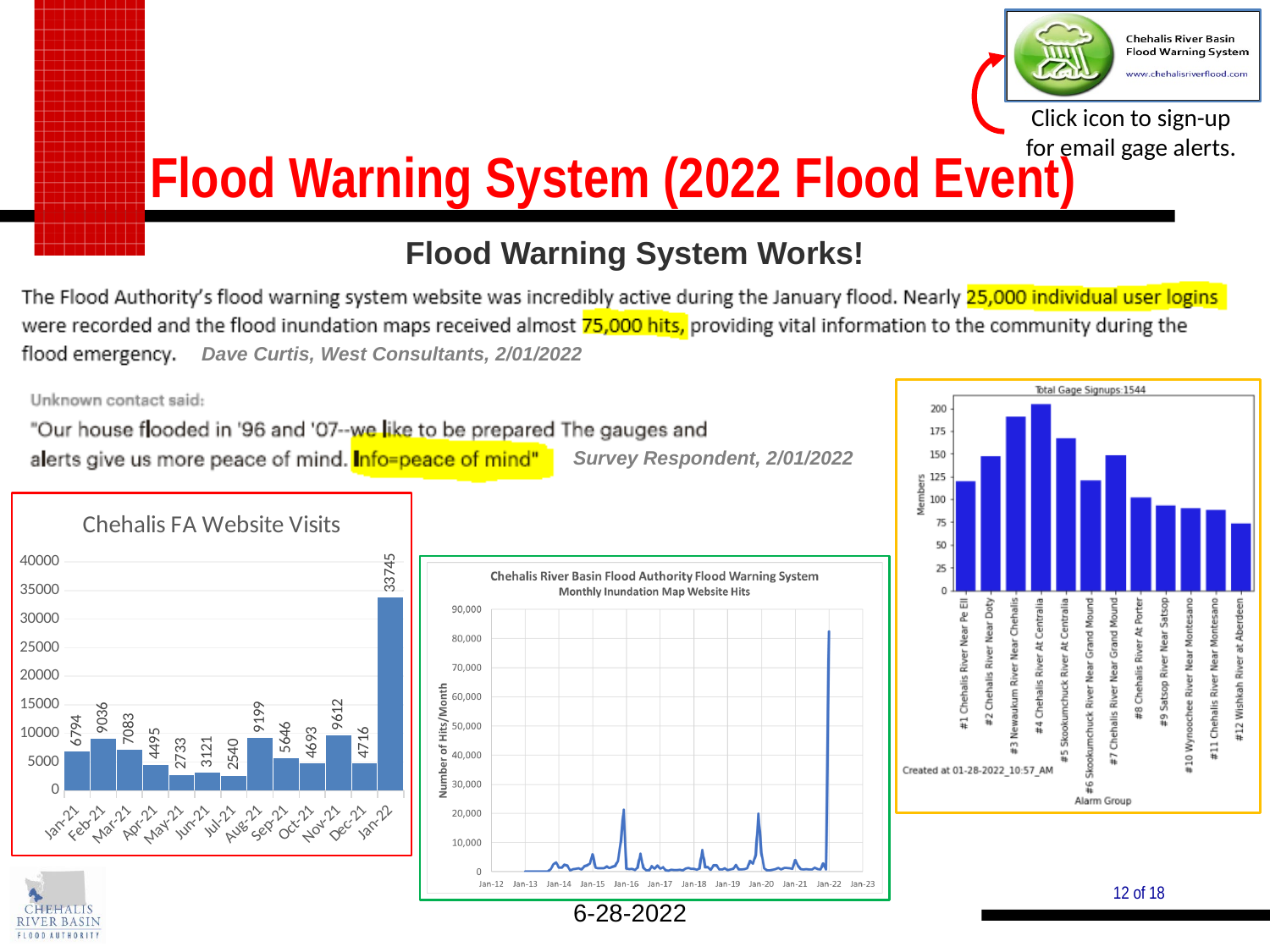
In the Total Gage Signups chart, is the value for #12 Wishkah River at Aberdeen greater or less than 100? less In the Chehalis FA Website Visits chart, what is the value for Aug-21? 9199 In the Chehalis FA Website Visits chart, which month has the lowest value? Jul-21 In the Chehalis FA Website Visits chart, which month has the highest value? Jan-22 What total is stated in the title of the Total Gage Signups chart? 1544 In the Chehalis FA Website Visits chart, what is the difference between the values for Nov-21 and Dec-21? 4896 In the Chehalis FA Website Visits chart, which is larger, the value for Feb-21 or the value for Mar-21? Feb-21 In the Chehalis FA Website Visits chart, what is the value for Jan-22? 33745 In the Total Gage Signups chart, which alarm group has the most members? #4 Chehalis River At Centralia What kind of chart is the Monthly Inundation Map Website Hits chart in the middle of the slide? line chart How many months are shown in the Chehalis FA Website Visits chart? 13